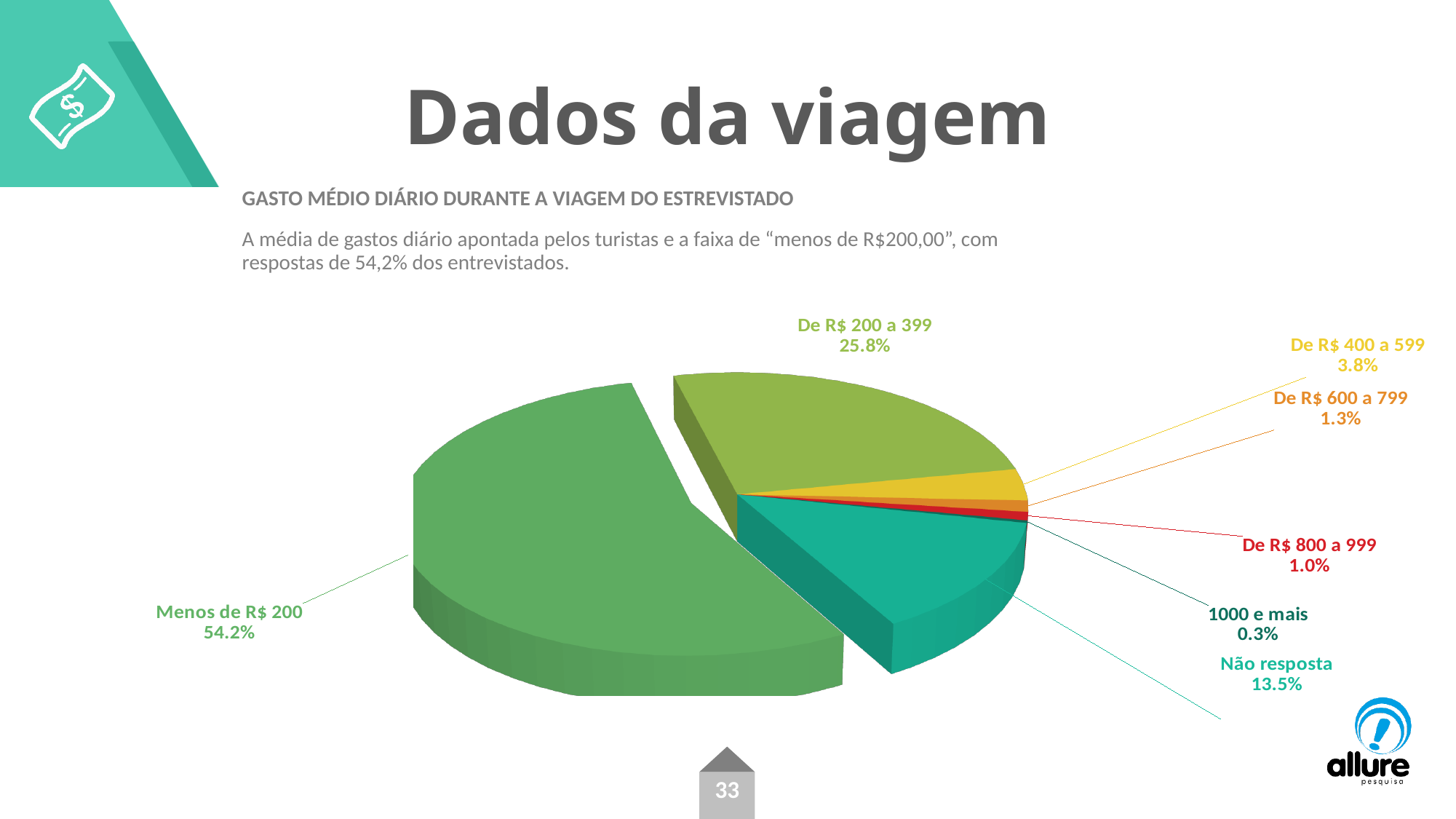
Which is larger, 'De R$ 600 a 799' or 'De R$ 800 a 999'? De R$ 600 a 799 Which category has the largest slice of the pie? Menos de R$ 200 What is the value for 'De R$ 200 a 399'? 25.8% What share of respondents reported spending 'Menos de R$ 200'? 54.2% What is the subtitle printed above the chart? GASTO MÉDIO DIÁRIO DURANTE A VIAGEM DO ESTREVISTADO Which category has the smallest slice of the pie? 1000 e mais What is the value for 'De R$ 400 a 599'? 3.8% How many categories are shown in the pie chart? 7 What is the value for 'Não resposta'? 13.5% What is the value for '1000 e mais'? 0.3% What is the difference between 'Menos de R$ 200' and 'De R$ 200 a 399'? 28.4% What kind of chart is shown on the slide? pie chart